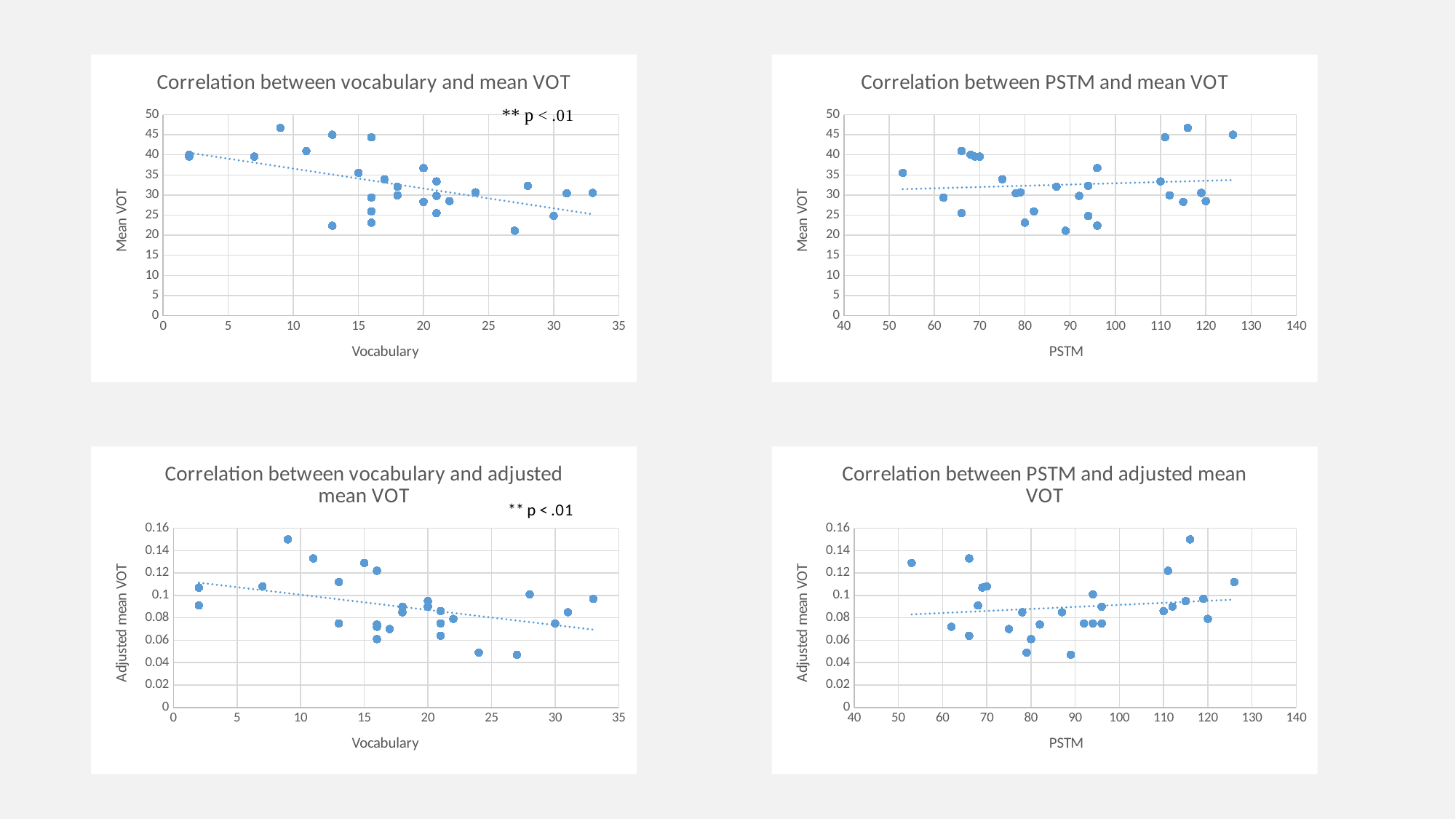
How many charts are shown on the slide? 4 In the 'Correlation between vocabulary and mean VOT' chart, is the lowest Mean VOT value plotted greater or less than 25? less What is the x-axis label of the 'Correlation between PSTM and mean VOT' chart? PSTM In the 'Correlation between PSTM and adjusted mean VOT' chart, does the dotted trend line rise or fall as PSTM increases? rise In the 'Correlation between vocabulary and adjusted mean VOT' chart, is the highest adjusted mean VOT value plotted greater or less than 0.14? greater In the 'Correlation between vocabulary and mean VOT' chart, does the dotted trend line rise or fall as Vocabulary increases? fall In the 'Correlation between vocabulary and adjusted mean VOT' chart, does the dotted trend line rise or fall as Vocabulary increases? fall What is the y-axis label of the 'Correlation between vocabulary and adjusted mean VOT' chart? Adjusted mean VOT What kind of chart is the 'Correlation between vocabulary and mean VOT' chart? scatter chart In the 'Correlation between vocabulary and mean VOT' chart, is the highest Mean VOT value plotted greater or less than 45? greater